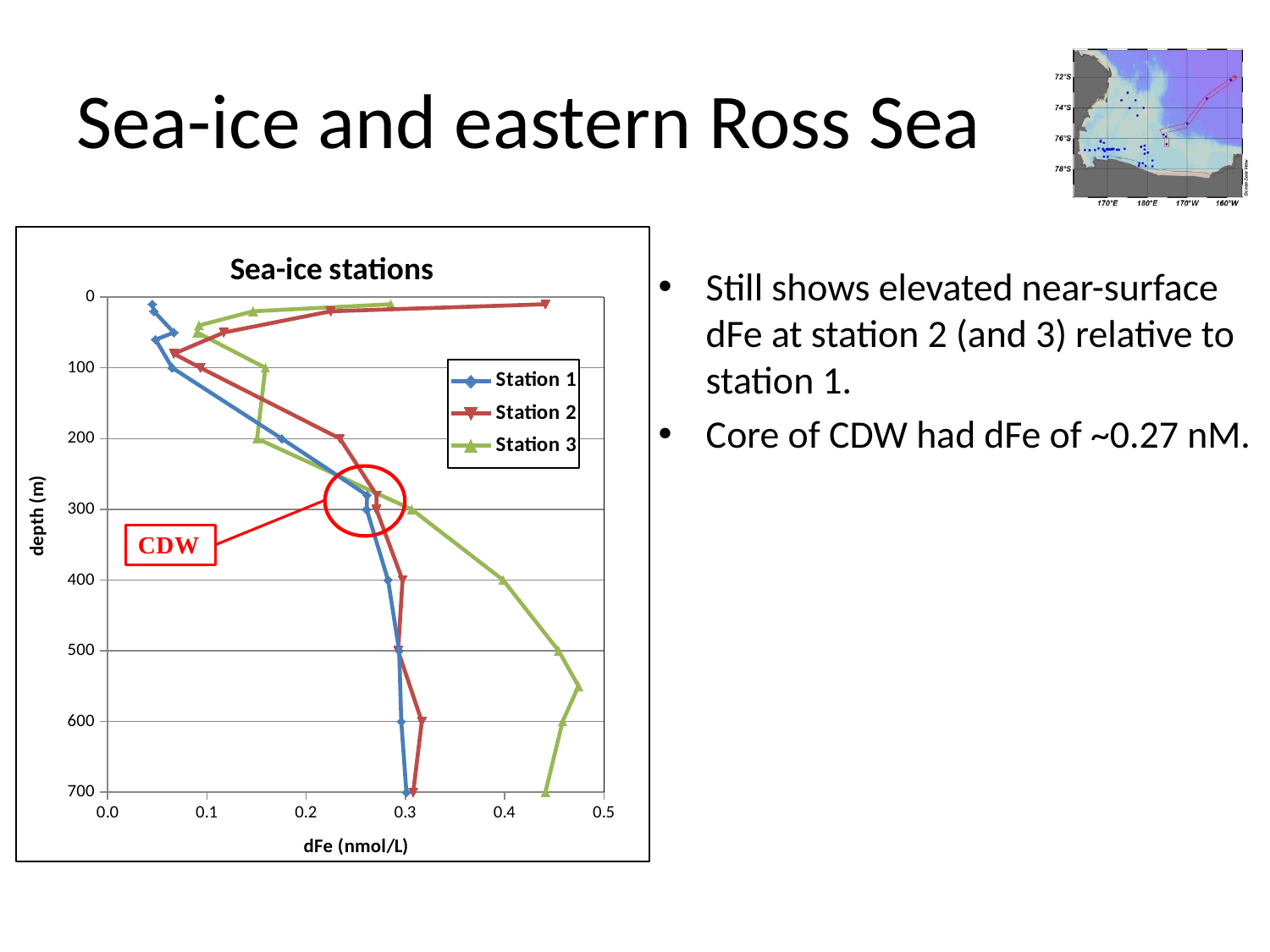
In the "Sea-ice stations" chart, is the dFe value for Station 3 at 200 m depth greater or less than 0.2? less What kind of chart is shown under the title "Sea-ice stations"? line chart In the "Sea-ice stations" chart, is the near-surface dFe value for Station 2 greater or less than 0.4? greater In the "Sea-ice stations" chart, does the dFe for Station 1 increase or decrease as depth goes from 100 m to 700 m? increase In the "Sea-ice stations" chart, which station has the lowest dFe at 600 m depth? Station 1 In the "Sea-ice stations" chart, which station has the higher near-surface dFe, Station 1 or Station 2? Station 2 In the "Sea-ice stations" chart, which station has the higher dFe at 500 m depth, Station 1 or Station 3? Station 3 How many series does the legend of the "Sea-ice stations" chart list? 3 In the "Sea-ice stations" chart, is the dFe value for Station 3 at 500 m depth greater or less than 0.4? greater What are the series names in the legend of the "Sea-ice stations" chart? Station 1, Station 2, Station 3 What is the x-axis label of the "Sea-ice stations" chart? dFe (nmol/L)